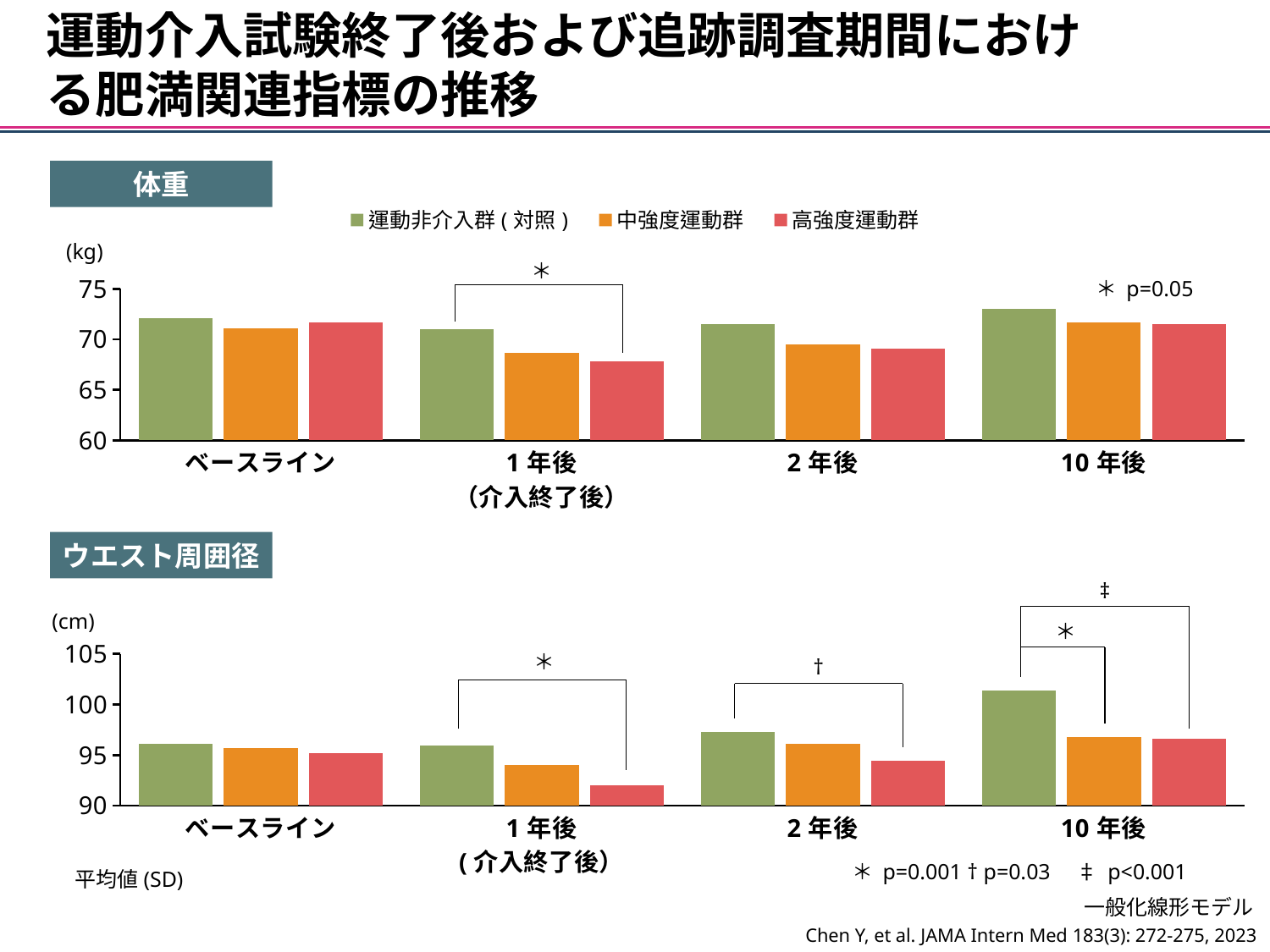
In the 体重 chart, is the value for 運動非介入群(対照) at 10年後 greater or less than 70? greater How many time-point categories are shown on the x axis of the ウエスト周囲径 chart? 4 In the ウエスト周囲径 chart, is the value for 高強度運動群 at 1年後 greater or less than 95? less In the ウエスト周囲径 chart, is the value for 運動非介入群(対照) at 10年後 greater or less than 100? greater How many series does the legend list for the 体重 chart? 3 What kind of chart is the 体重 chart? bar chart What unit is shown on the y axis of the ウエスト周囲径 chart? cm In the 体重 chart, at 1年後, which is larger: 運動非介入群(対照) or 高強度運動群? 運動非介入群(対照) In the 体重 chart, at which time point is the 高強度運動群 bar lowest? 1年後 In the ウエスト周囲径 chart, which series has the highest bar at 10年後? 運動非介入群(対照) In the ウエスト周囲径 chart, does the 運動非介入群(対照) value rise or fall from 1年後 to 10年後? rise